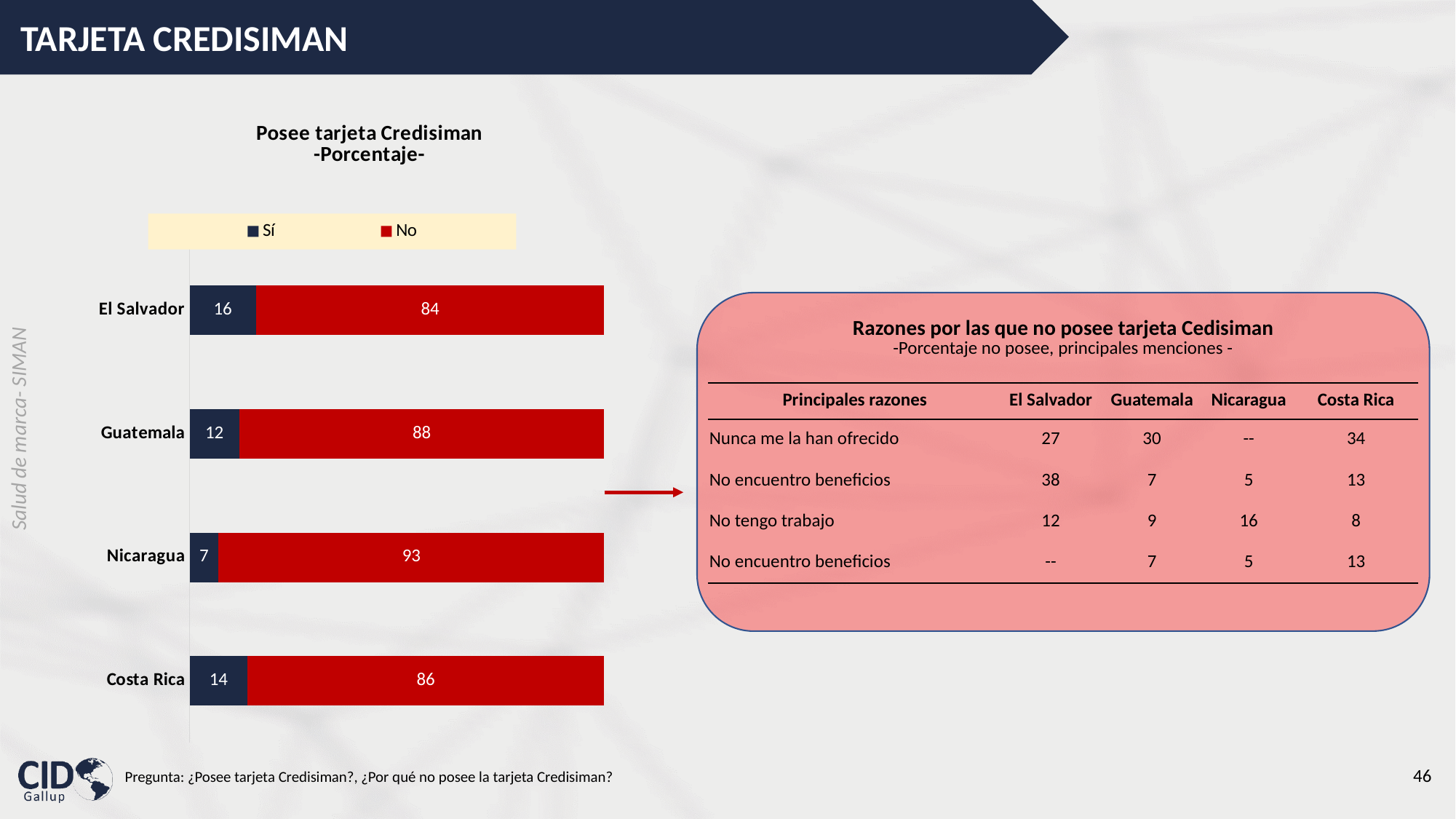
How many series does the legend of the 'Posee tarjeta Credisiman' chart list? 2 What is the total of the stacked bar for Costa Rica in the 'Posee tarjeta Credisiman' chart? 100 How many countries are shown in the 'Posee tarjeta Credisiman' chart? 4 Which country has the lowest 'Sí' value in the 'Posee tarjeta Credisiman' chart? Nicaragua What is the 'Sí' value for El Salvador in the 'Posee tarjeta Credisiman' chart? 16 What is the 'No' value for Guatemala in the 'Posee tarjeta Credisiman' chart? 88 What type of chart is the 'Posee tarjeta Credisiman' chart? Stacked bar chart What is the difference between the 'No' values for Nicaragua and El Salvador in the 'Posee tarjeta Credisiman' chart? 9 Which country has the highest 'No' value in the 'Posee tarjeta Credisiman' chart? Nicaragua In the 'Posee tarjeta Credisiman' chart, which is larger: the 'Sí' value for Costa Rica or the 'Sí' value for Guatemala? Costa Rica Which country has the highest 'Sí' value in the 'Posee tarjeta Credisiman' chart? El Salvador What is the 'No' value for Nicaragua in the 'Posee tarjeta Credisiman' chart? 93